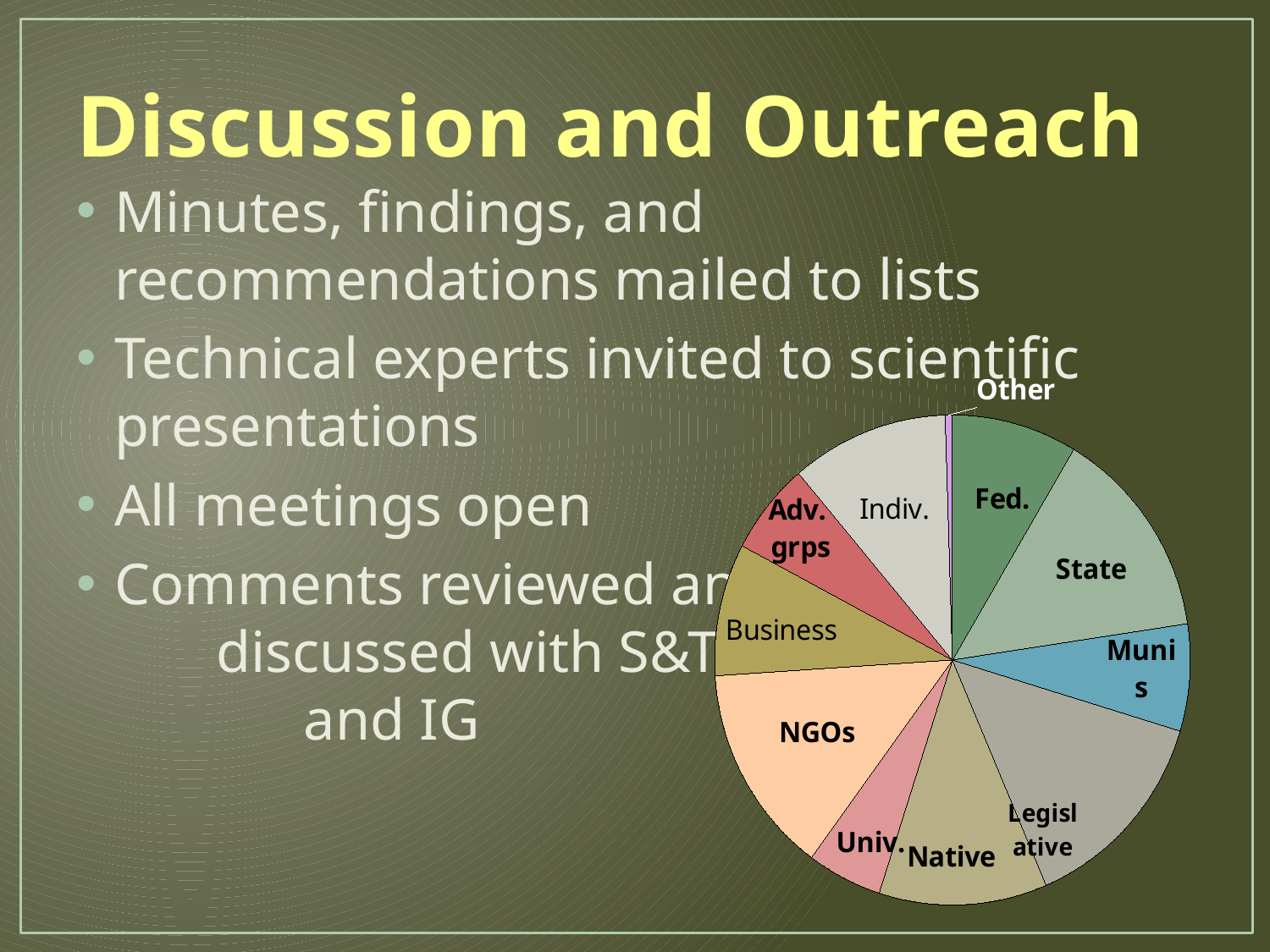
Which slice is larger, NGOs or Univ.? NGOs Which slice of the pie chart is the smallest? Other What colour is the Munis slice of the pie chart? blue Which slice is larger, Fed. or Other? Fed. What kind of chart is shown on the slide? pie chart Which slice is larger, State or Munis? State How many slices does the pie chart have? 11 What colour is the Fed. slice of the pie chart? green